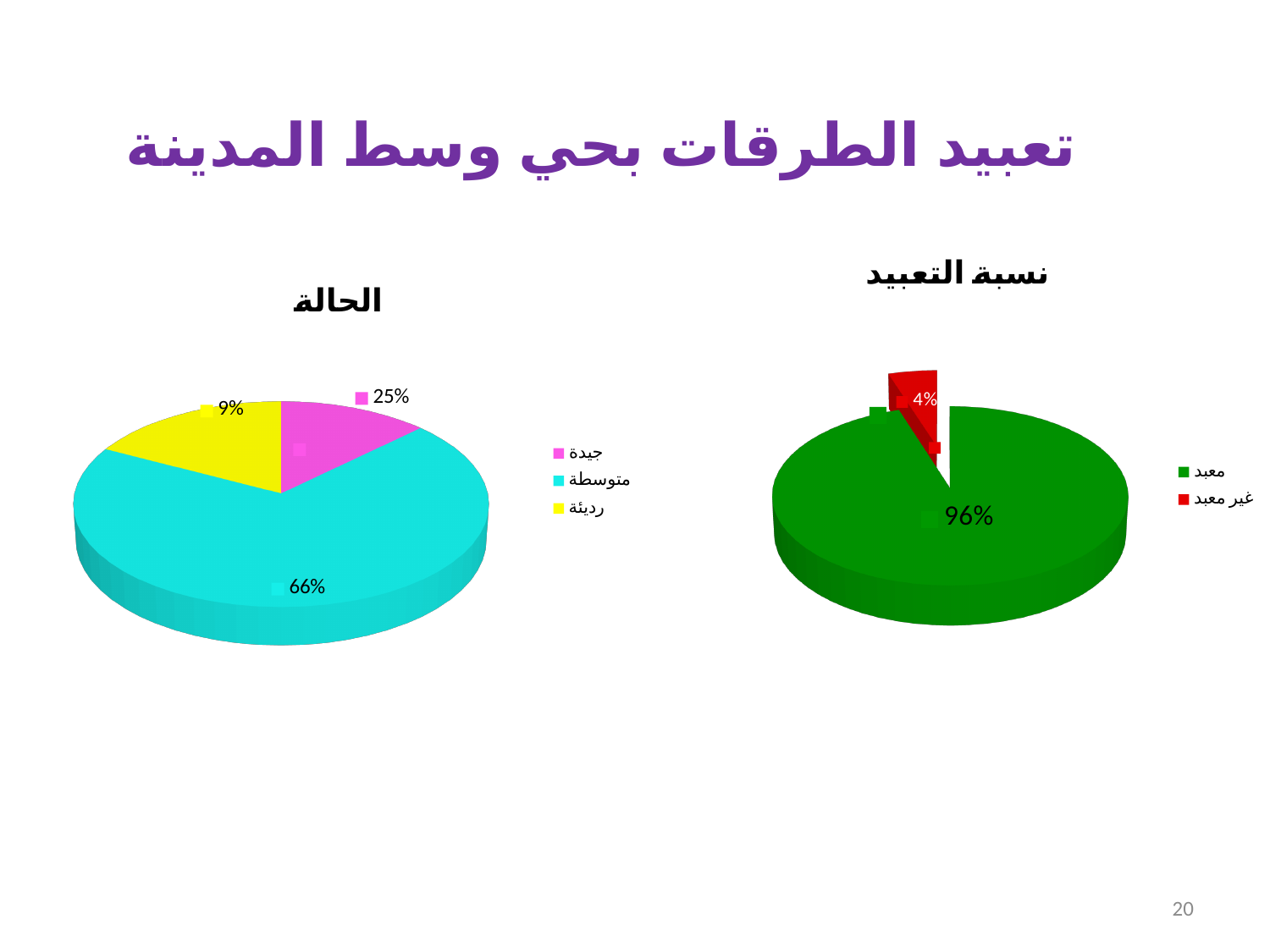
In the chart titled "الحالة" (left), what share does "جيدة" have? 25% In the chart titled "الحالة" (left), what share does "رديئة" have? 9% In the chart titled "نسبة التعبيد" (right), what colour is the "غير معبد" slice? Red What kind of chart is the chart titled "نسبة التعبيد" (right)? Pie chart In the chart titled "الحالة" (left), what share does "متوسطة" have? 66% In the chart titled "الحالة" (left), what is the difference between the shares of "متوسطة" and "جيدة"? 41% In the chart titled "نسبة التعبيد" (right), which category is larger, "معبد" or "غير معبد"? معبد In the chart titled "الحالة" (left), which category has the largest slice? متوسطة In the chart titled "الحالة" (left), which category has the smallest slice? رديئة In the chart titled "الحالة" (left), how many categories does the legend list? 3 In the chart titled "نسبة التعبيد" (right), what share does "معبد" have? 96% In the chart titled "نسبة التعبيد" (right), what share does "غير معبد" have? 4%